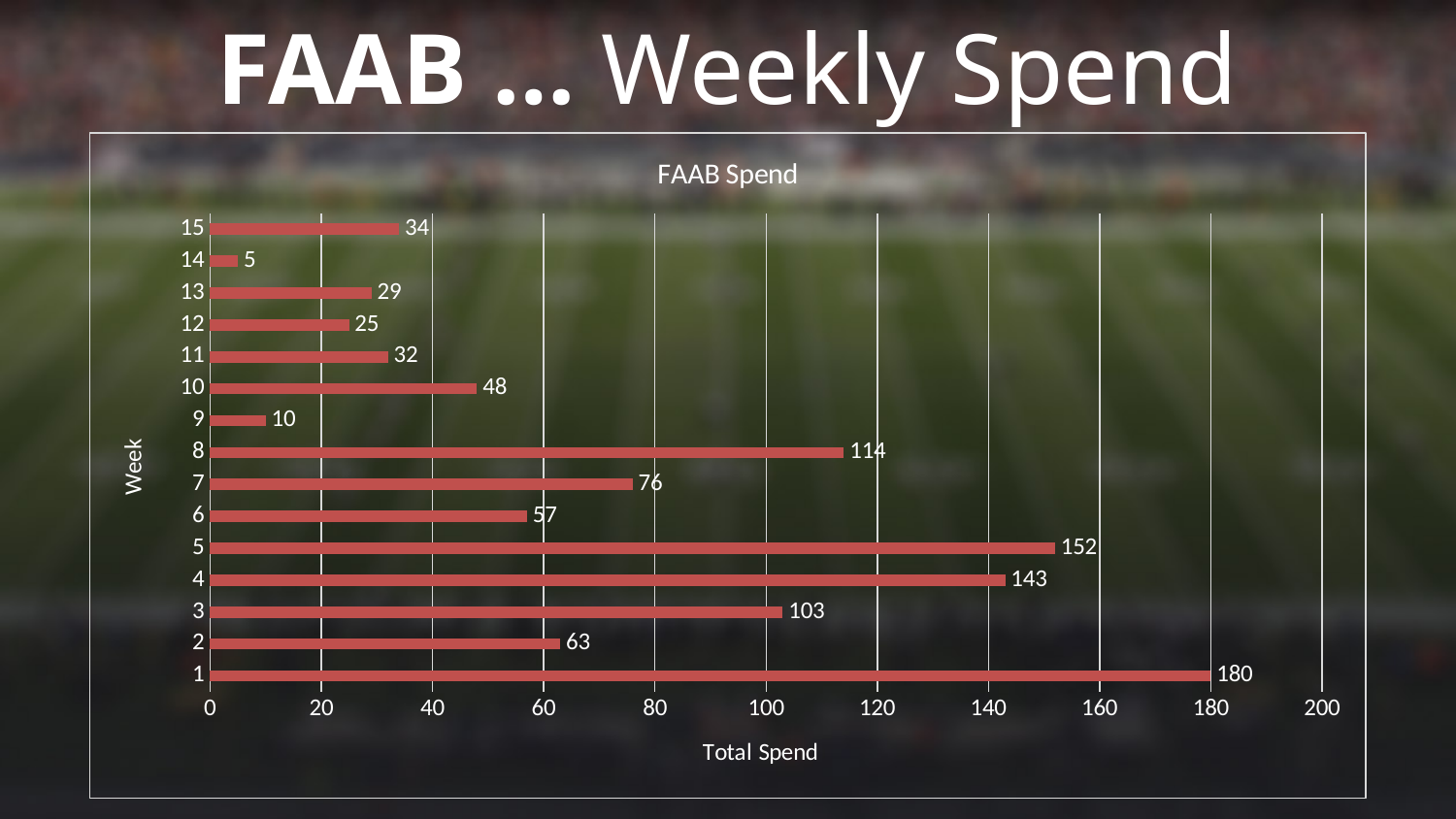
Which week has the lowest total spend? Week 14 Which week has a larger total spend, week 7 or week 6? Week 7 What is the label of the horizontal axis? Total Spend What is the total spend for week 14? 5 What is the difference in total spend between week 5 and week 4? 9 Which week has the highest total spend? Week 1 What is the title of the chart? FAAB Spend What kind of chart is shown on the slide? Bar chart What is the total spend for week 10? 48 What is the difference in total spend between week 1 and week 2? 117 How many weeks are shown in the chart? 15 What is the total spend for week 8? 114